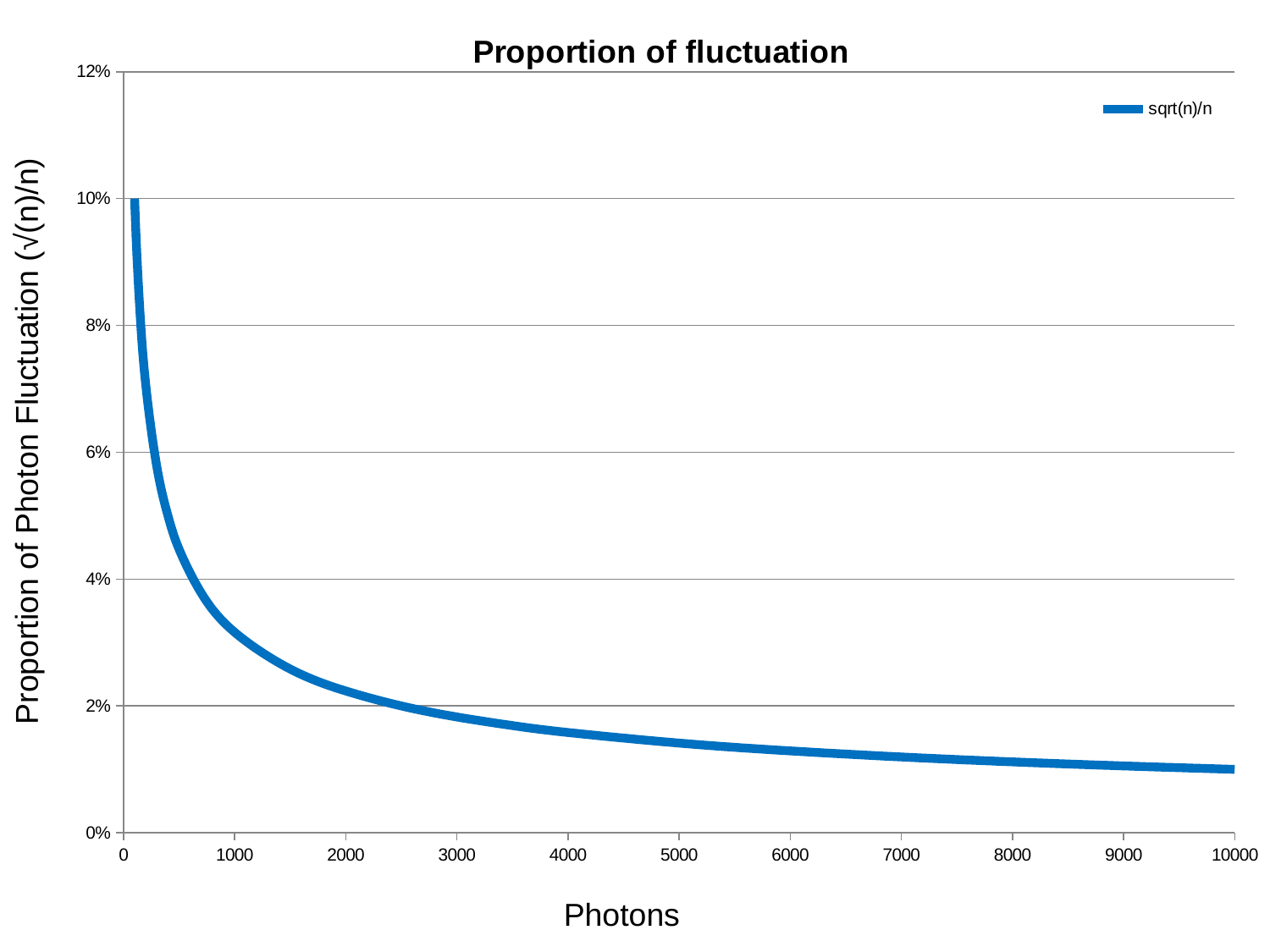
What is the name of the series shown in the legend? sqrt(n)/n What is the label of the x axis? Photons Is the value for 500 photons greater or less than 4%? greater Is the value for 1000 photons greater or less than 4%? less Is the value for 10000 photons greater or less than 2%? less How many series does the legend list? 1 Does the plotted value rise or fall as the number of photons increases along the x axis? fall What is the title of the chart? Proportion of fluctuation What kind of chart is shown on the slide? line chart Which has the larger value, 1000 photons or 9000 photons? 1000 photons